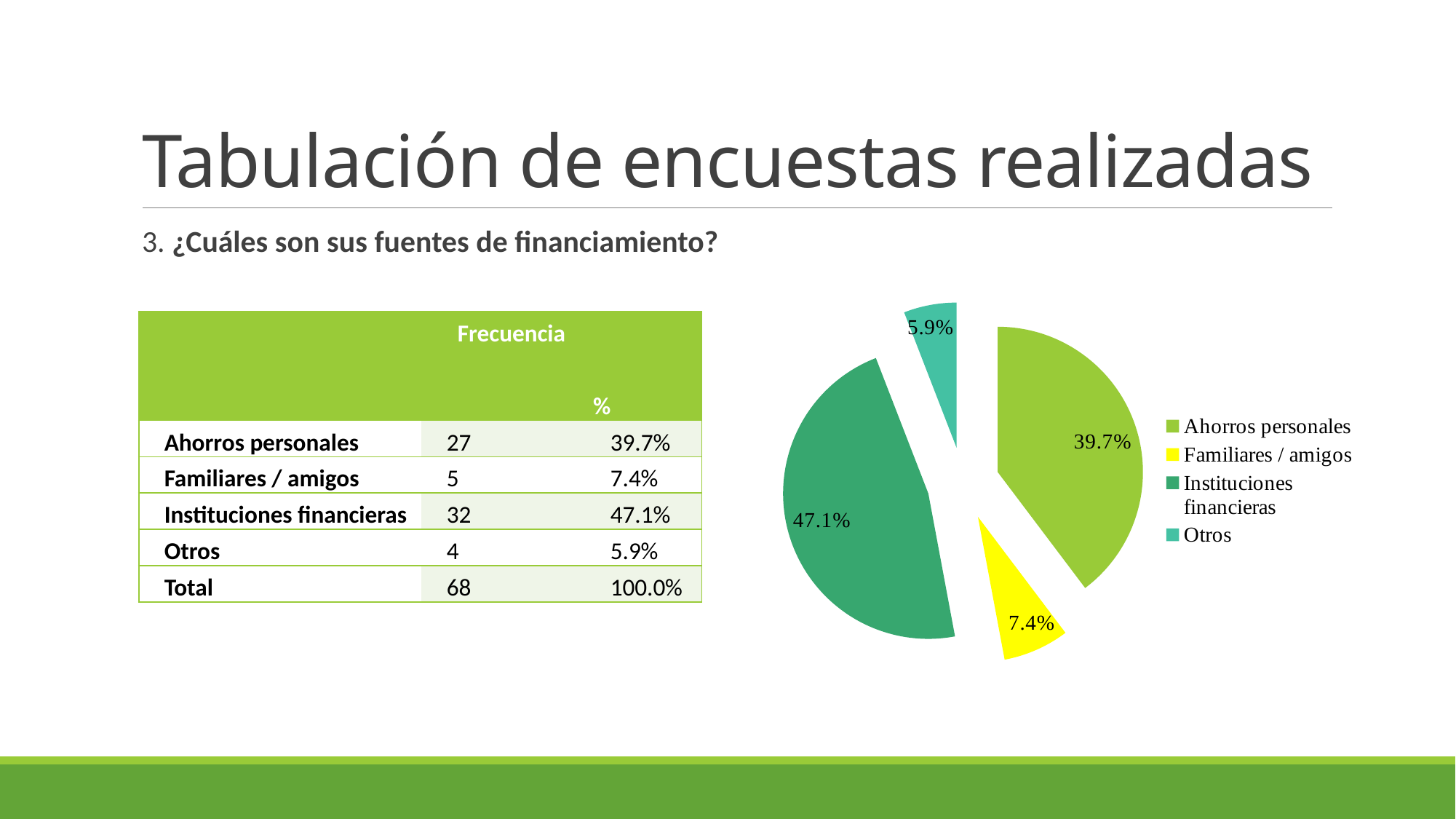
How many entries does the legend list? 4 Which is larger, the slice for Familiares / amigos or the slice for Otros? Familiares / amigos How many slices does the pie chart have? 4 Which category has the smallest slice of the pie? Otros What share of the pie does Otros have? 5.9% What is the difference in percentage points between Instituciones financieras and Ahorros personales? 7.4 What colour is the slice for Familiares / amigos? yellow What share of the pie does Ahorros personales have? 39.7% What share of the pie does Instituciones financieras have? 47.1% What kind of chart is shown on the slide? pie chart Which category has the largest slice of the pie? Instituciones financieras